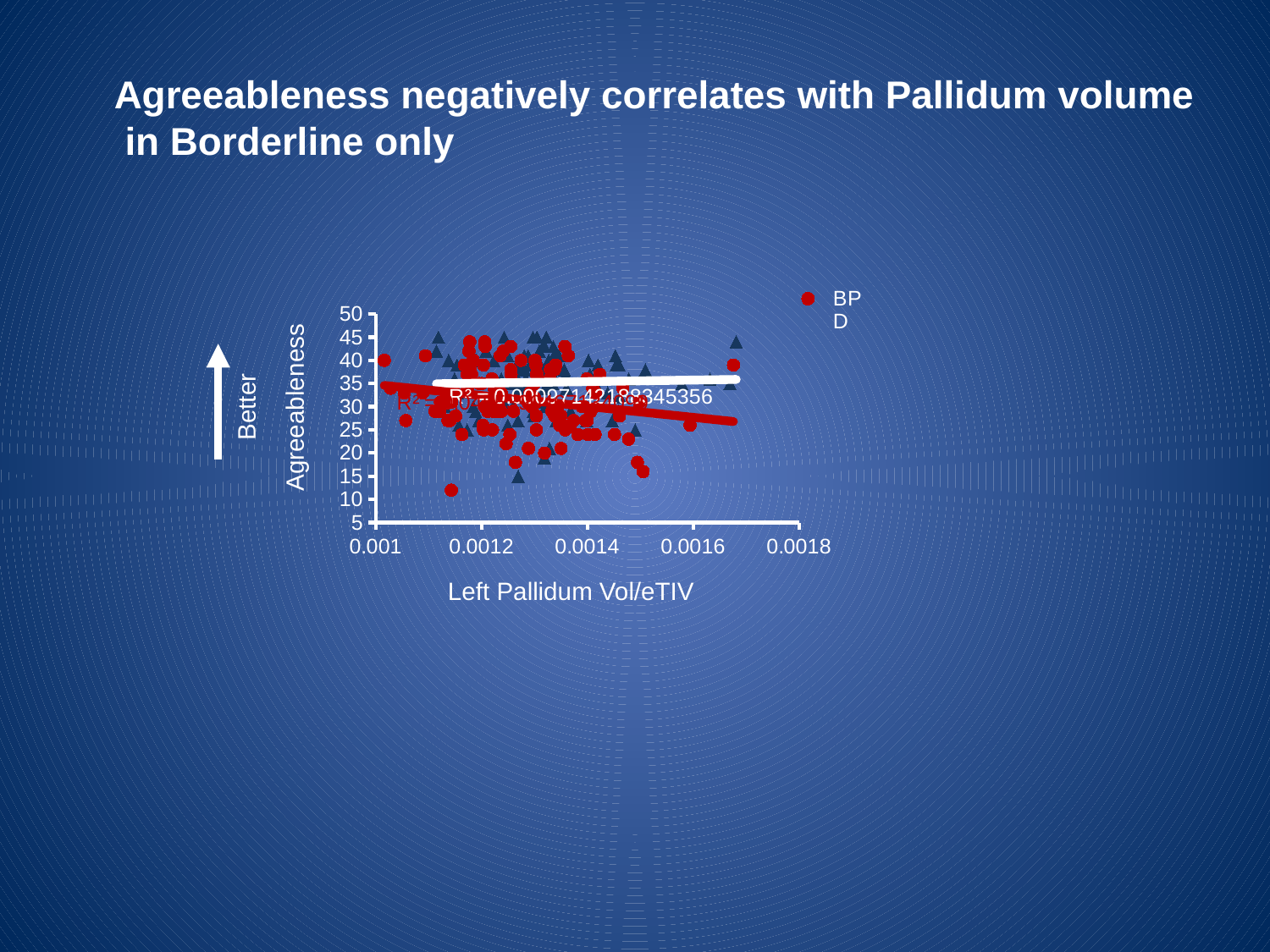
What kind of chart is shown on the slide? scatter chart What series name is shown in the chart's legend? BPD Does the red trendline for the BPD points rise or fall as Left Pallidum Vol/eTIV increases? fall Which trendline slopes downward, the red one or the white one? the red one What is the title of the x axis of the chart? Left Pallidum Vol/eTIV Is the lowest Agreeableness value plotted for BPD greater or less than 15? less Is the highest Agreeableness value plotted for BPD greater or less than 40? greater How many data series are plotted in the chart (by marker type)? 2 Is the Left Pallidum Vol/eTIV value of the rightmost BPD point greater or less than 0.0018? less